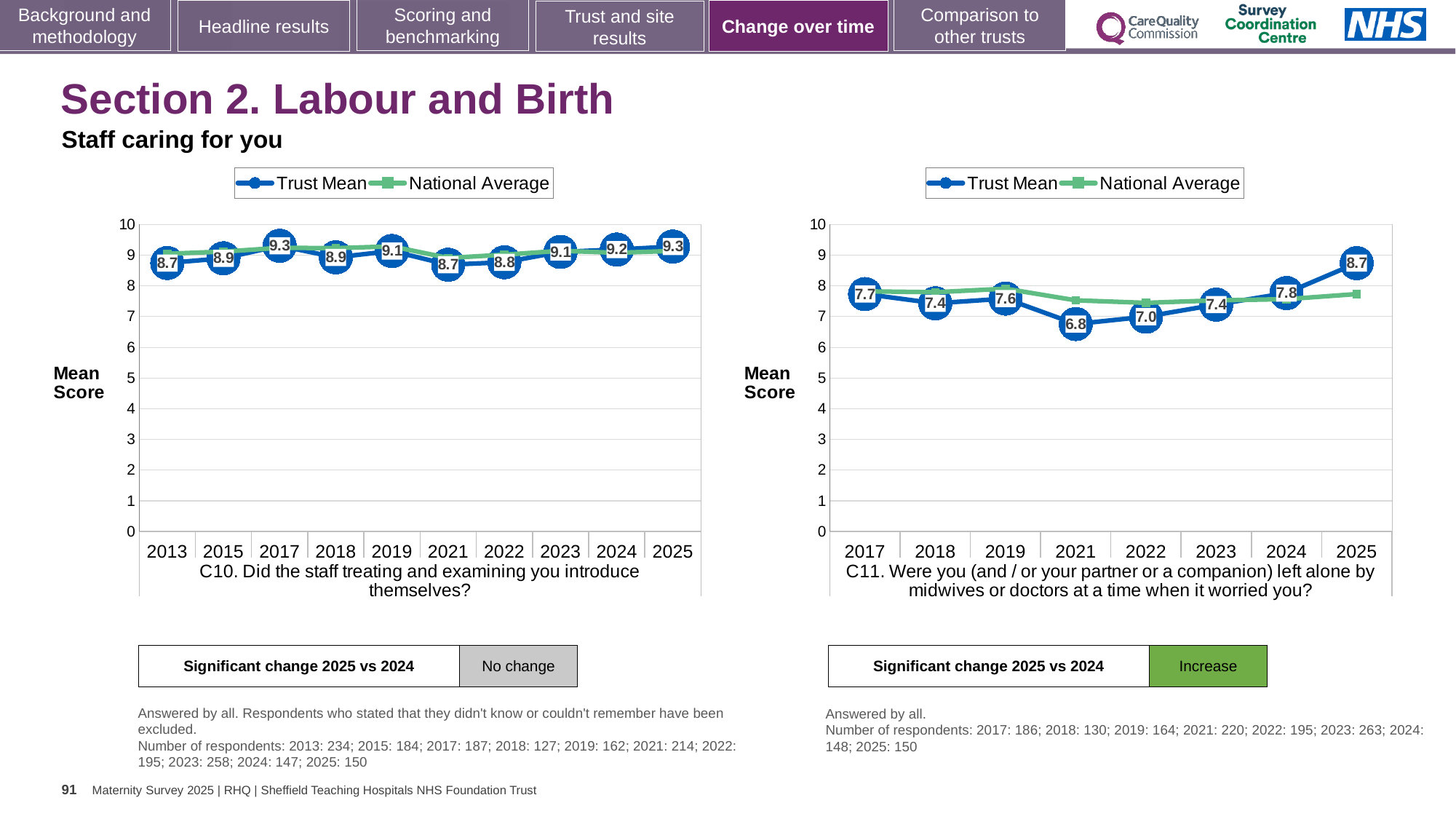
How many series does the legend of the C10 chart (left) list? 2 On the C10 chart (left), what is the Trust Mean score for 2021? 8.7 On the C11 chart (right), which year has the lowest Trust Mean score? 2021 What kind of chart is the C10 chart (left)? Line chart On the C11 chart (right), is the National Average value for 2021 greater or less than 7? greater On the C10 chart (left), what is the difference between the Trust Mean scores for 2017 and 2018? 0.4 On the C10 chart (left), what is the Trust Mean score for 2025? 9.3 On the C11 chart (right), which year has the highest Trust Mean score? 2025 On the C11 chart (right), what is the difference between the Trust Mean scores for 2025 and 2024? 0.9 On the C11 chart (right), is the Trust Mean score higher in 2019 or in 2021? 2019 On the C11 chart (right), what is the Trust Mean score for 2022? 7.0 How many years are plotted on the C11 chart (right)? 8